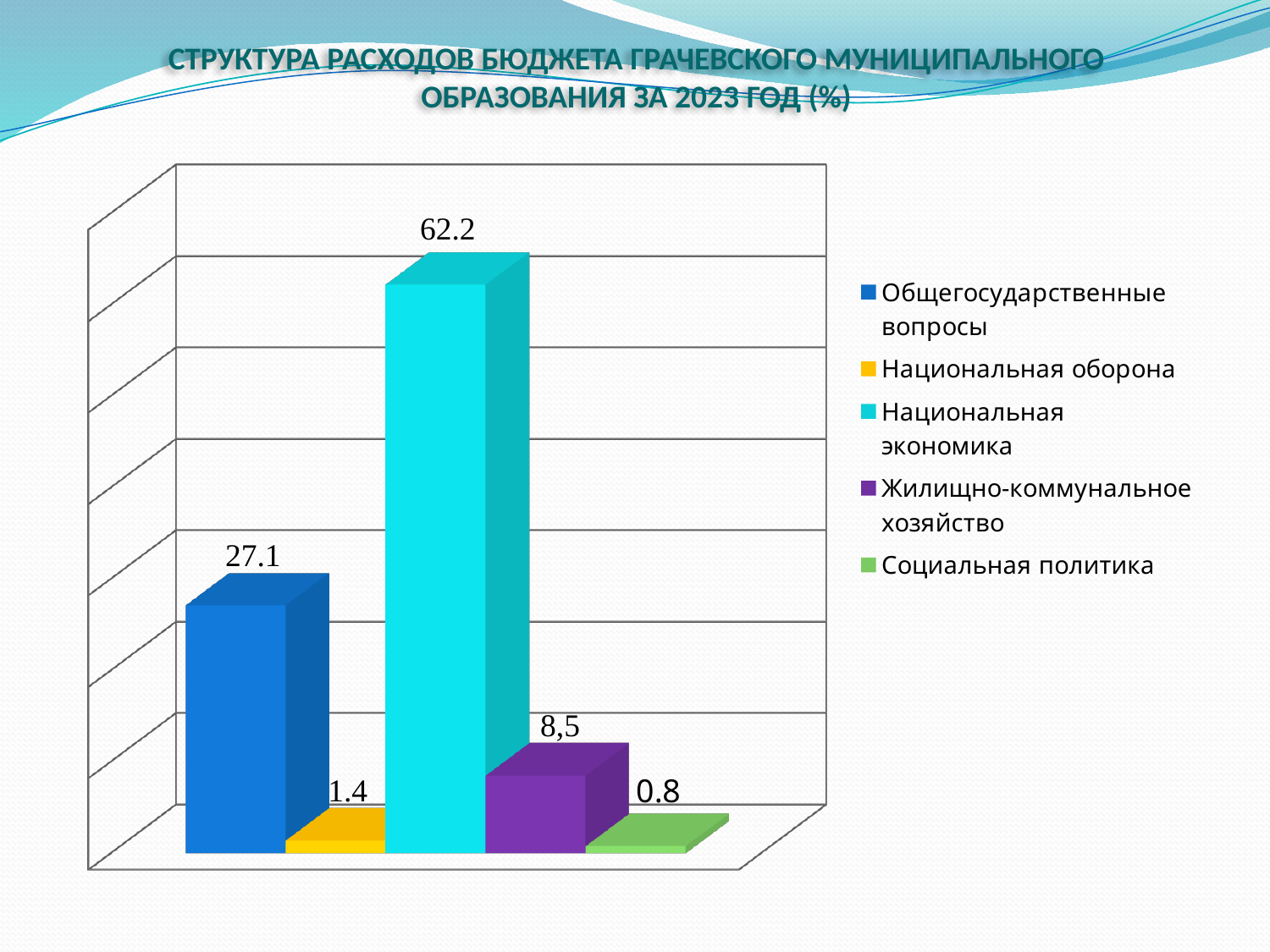
What is the value for Общегосударственные вопросы? 27.1 Which category has the highest value? Национальная экономика What colour is the bar for Национальная оборона? Yellow Which category has the lowest value? Социальная политика What is the value for Национальная оборона? 1.4 How many categories are plotted in the chart? 5 What kind of chart is shown on the slide? Bar chart What is the difference between the values for Национальная экономика and Общегосударственные вопросы? 35.1 What is the value for Жилищно-коммунальное хозяйство? 8,5 What is the value for Социальная политика? 0.8 Which is larger, the value for Общегосударственные вопросы or the value for Жилищно-коммунальное хозяйство? Общегосударственные вопросы What is the value for Национальная экономика? 62.2